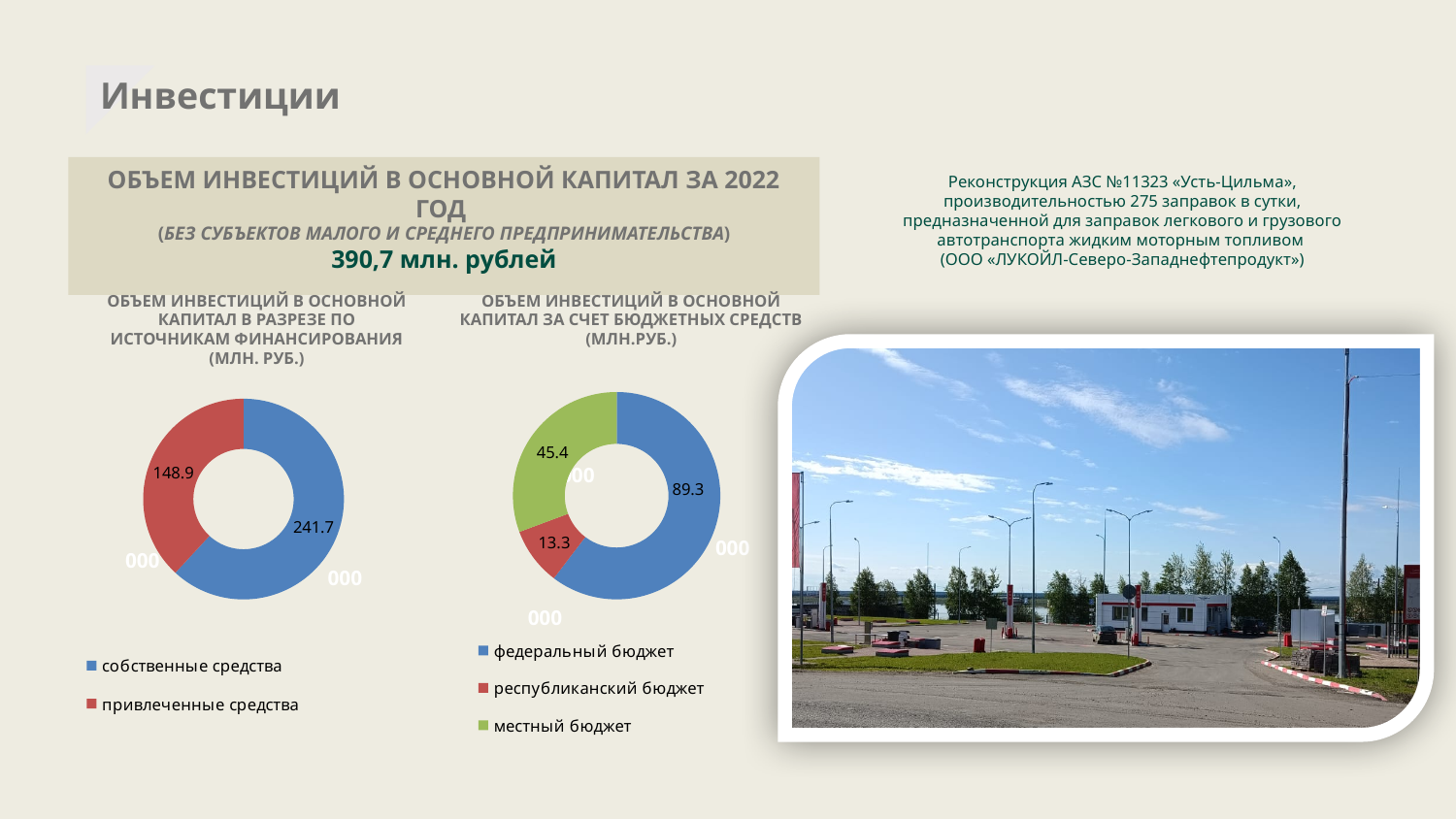
In the right chart (investment from budget funds), which budget source has the largest value? федеральный бюджет In the left chart (investment by source of financing), what is the value for привлеченные средства? 148.9 In the right chart (investment from budget funds), what is the value for федеральный бюджет? 89.3 In the left chart (investment by source of financing), what is the value for собственные средства? 241.7 In the left chart (investment by source of financing), what is the difference between собственные средства and привлеченные средства? 92.8 How many series does the legend of the right chart (investment from budget funds) list? 3 In the right chart (investment from budget funds), what is the difference between федеральный бюджет and местный бюджет? 43.9 What kind of chart is the left chart (investment by source of financing)? Pie (doughnut) chart In the right chart (investment from budget funds), what is the total of the three budget sources? 148.0 In the right chart (investment from budget funds), what is the value for местный бюджет? 45.4 In the right chart (investment from budget funds), which is larger: местный бюджет or республиканский бюджет? местный бюджет In the right chart (investment from budget funds), which budget source has the smallest value? республиканский бюджет